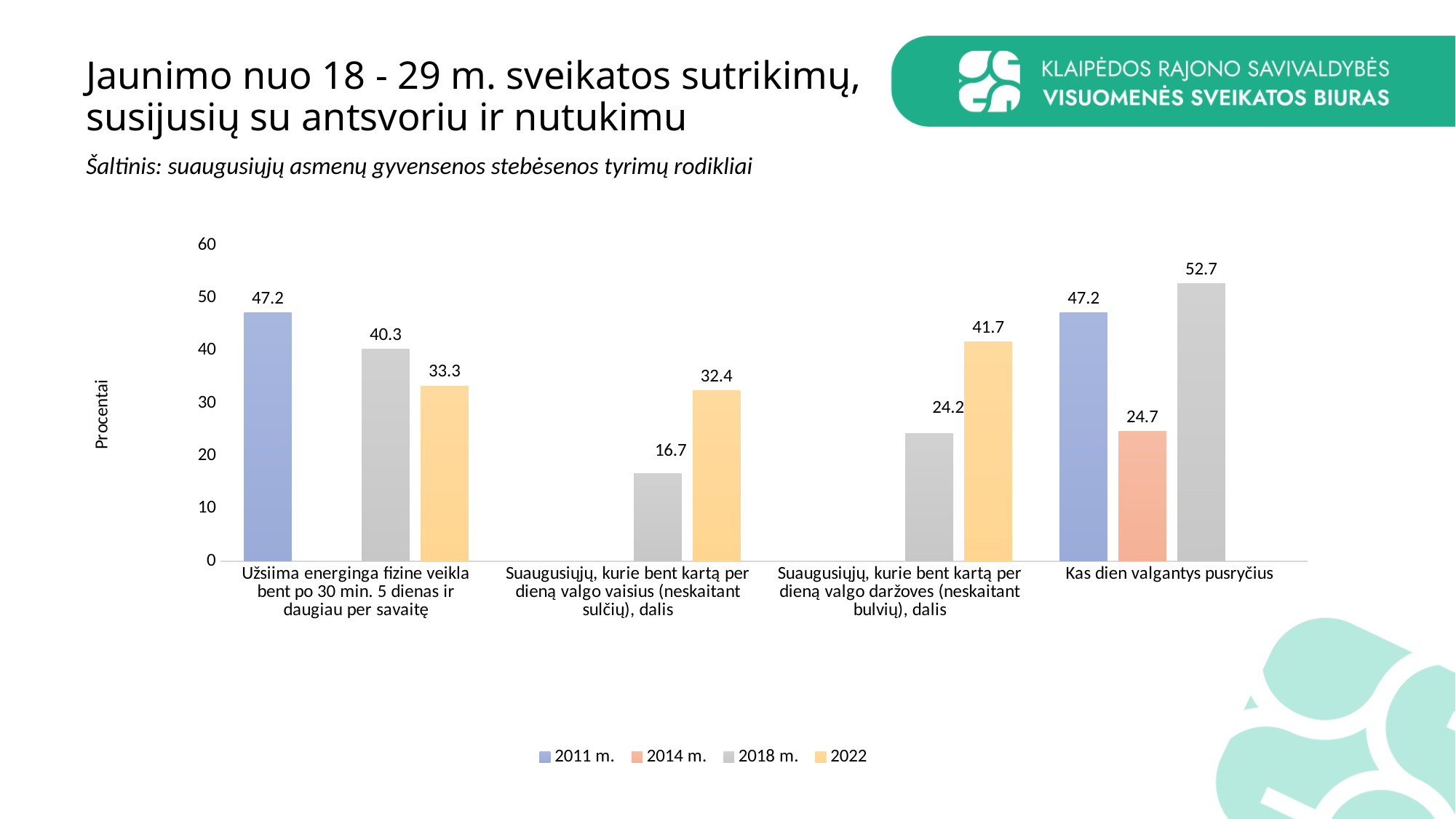
What is the value for 2018 m. in the category "Kas dien valgantys pusryčius"? 52.7 Which category has the highest 2018 m. value? Kas dien valgantys pusryčius How many series does the legend list? 4 What is the 2014 m. value for "Kas dien valgantys pusryčius"? 24.7 How many categories are shown on the x axis? 4 What is the 2011 m. value for "Užsiima energinga fizine veikla bent po 30 min. 5 dienas ir daugiau per savaitę"? 47.2 Which category has the lowest 2018 m. value? Suaugusiųjų, kurie bent kartą per dieną valgo vaisius (neskaitant sulčių), dalis Which is larger for "Užsiima energinga fizine veikla bent po 30 min. 5 dienas ir daugiau per savaitę": the 2018 m. value or the 2022 value? 2018 m. What is the 2022 value for "Suaugusiųjų, kurie bent kartą per dieną valgo vaisius (neskaitant sulčių), dalis"? 32.4 Is the 2018 m. value for "Kas dien valgantys pusryčius" greater or less than 50? greater What is the difference between the 2022 and 2018 m. values for "Suaugusiųjų, kurie bent kartą per dieną valgo daržoves (neskaitant bulvių), dalis"? 17.5 What kind of chart is shown on the slide? bar chart